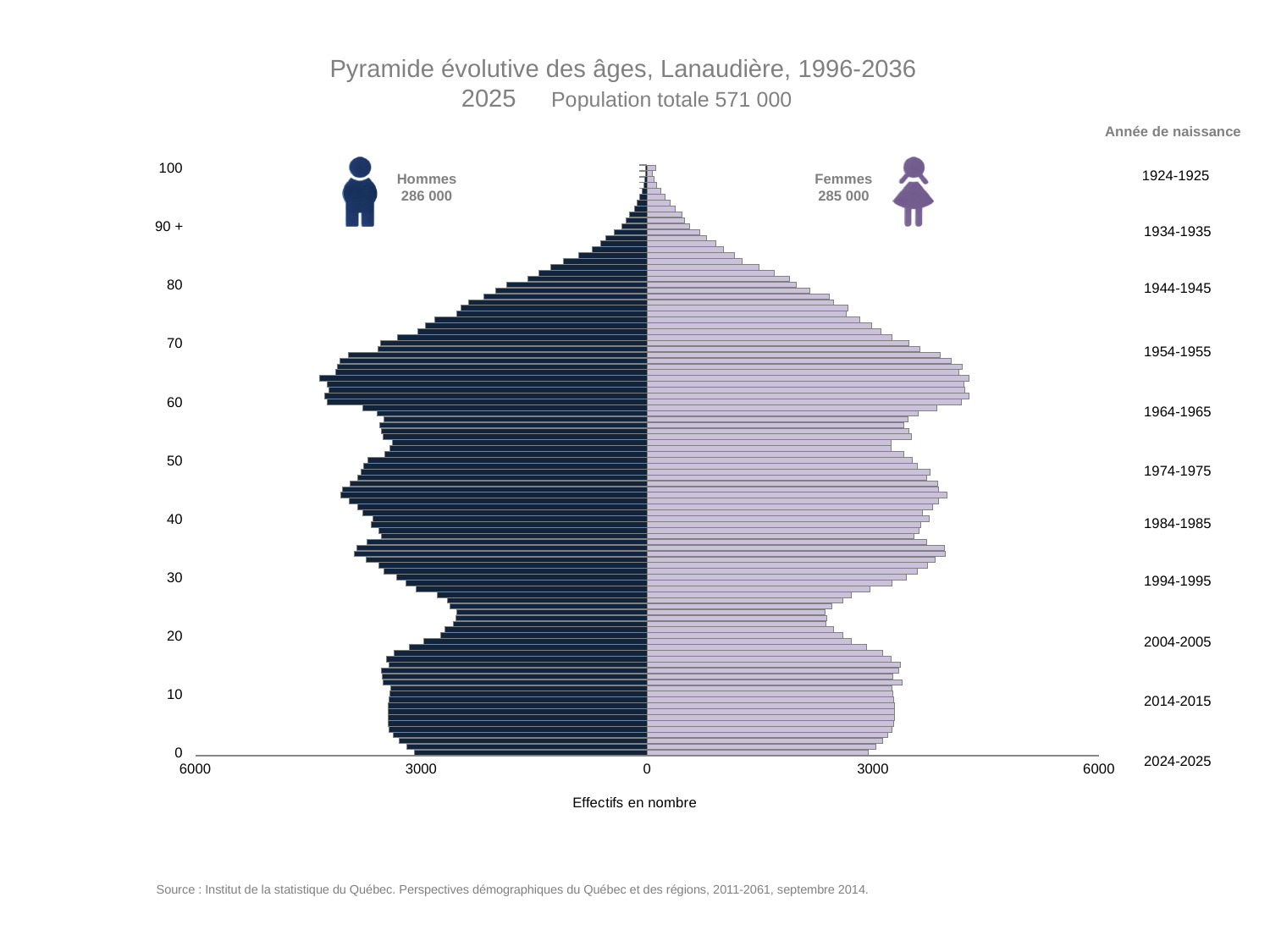
What is the number of Hommes (men) shown on the chart? 286 000 Is the value for Hommes at age 65 greater or less than 3000? greater What kind of chart is shown on the slide? Bar chart (population pyramid) What is the label of the horizontal axis? Effectifs en nombre What is the number of Femmes (women) shown on the chart? 285 000 How many population groups (series) does the chart show? 2 Which group is larger, Hommes or Femmes? Hommes Is the value for Femmes at age 90 greater or less than 3000? less What is the total population shown for 2025? 571 000 From age 65 up to age 100, do the bar lengths for Hommes rise or fall? fall Is the value for Femmes at age 25 greater or less than 3000? less What is the difference between the number of Hommes and the number of Femmes? 1 000